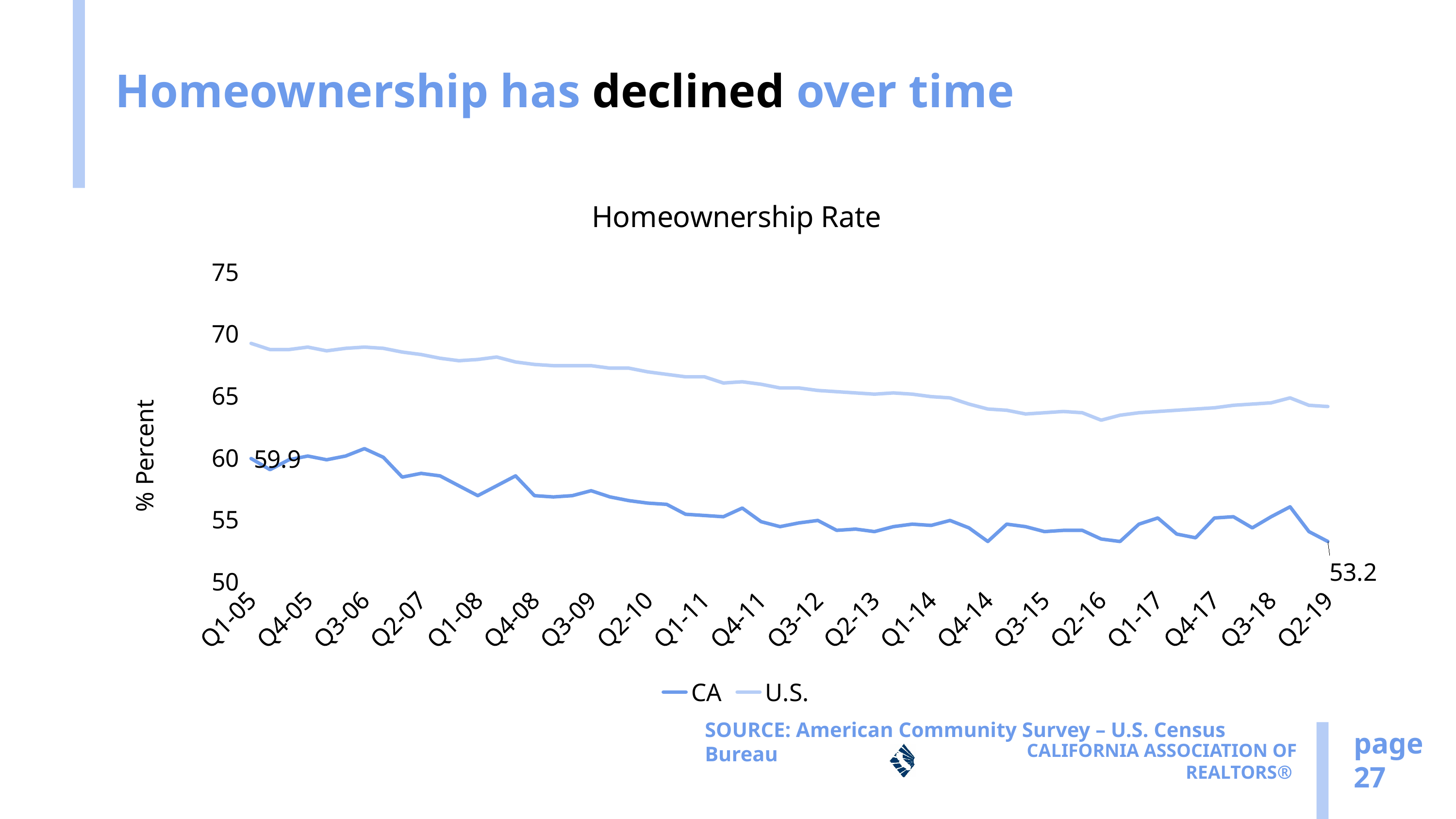
By how much did the CA homeownership rate fall from Q1-05 to Q2-19? 6.7 Is the U.S. homeownership rate at Q1-05 greater or less than 65? greater What is the CA homeownership rate at Q1-05? 59.9 Does the CA homeownership rate generally rise or fall from Q1-05 to Q2-19? fall What is the label on the vertical axis? % Percent What kind of chart is shown on the slide? line chart At Q2-19, which series has the higher homeownership rate, CA or U.S.? U.S. What is the title of the chart? Homeownership Rate What is the CA homeownership rate at Q2-19? 53.2 Is the U.S. homeownership rate at Q2-19 greater or less than 60? greater Is the CA homeownership rate at Q2-19 greater or less than 55? less How many series does the legend list? 2